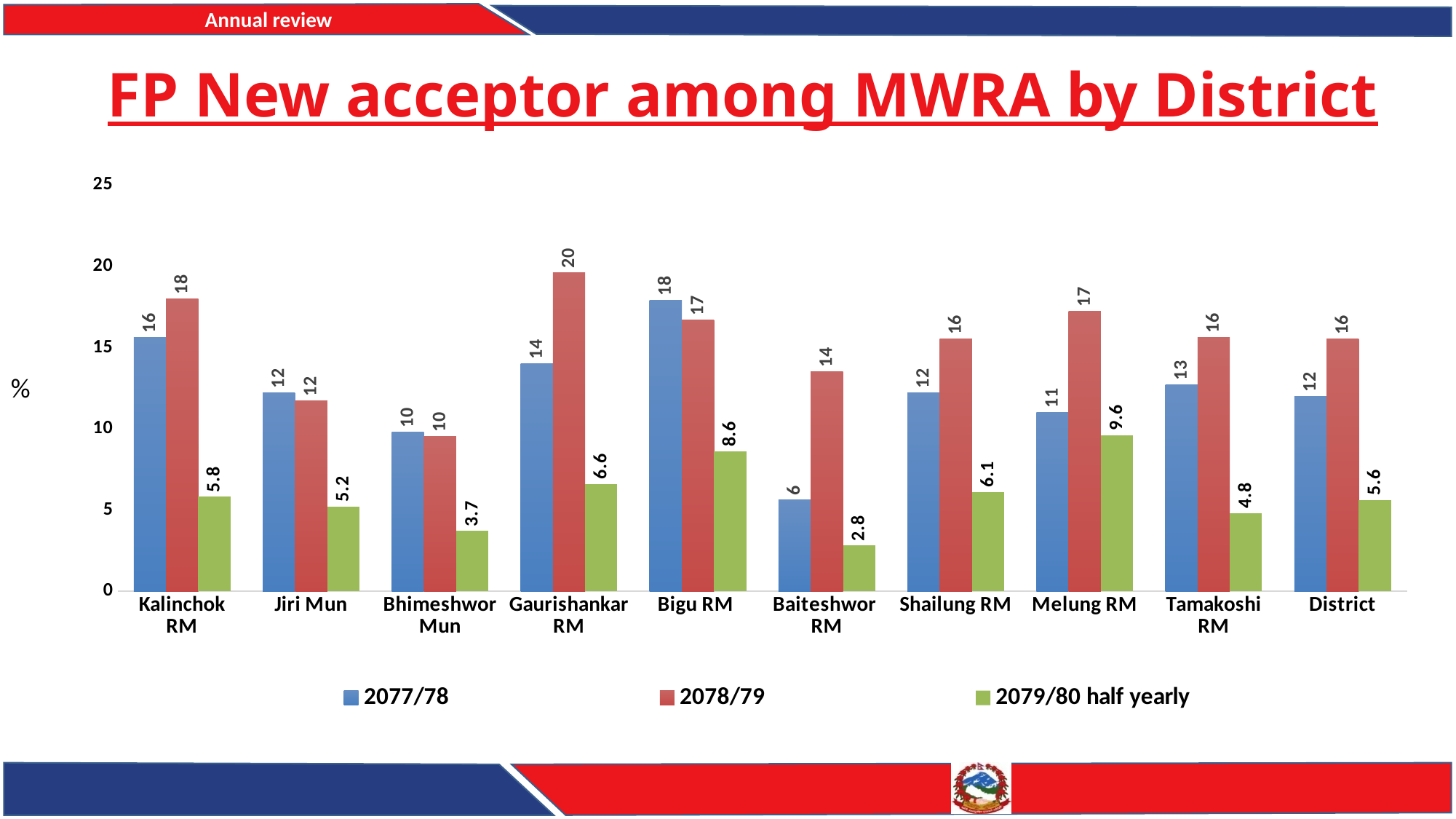
Which category has the lowest value in the 2079/80 half yearly series? Baiteshwor RM What is the title of the chart? FP New acceptor among MWRA by District What is the value for Bigu RM in the 2077/78 series? 18 How many categories are shown on the x axis? 10 What kind of chart is shown on the slide? bar chart What is the value for Gaurishankar RM in the 2078/79 series? 20 Which is larger for Kalinchok RM: the 2077/78 value or the 2078/79 value? 2078/79 Which category has the highest value in the 2078/79 series? Gaurishankar RM How many series does the legend list? 3 Is the 2079/80 half yearly value for Bhimeshwor Mun greater or less than 5? less What is the difference between the 2078/79 and 2077/78 values for Baiteshwor RM? 8 What is the 2079/80 half yearly value for Melung RM? 9.6